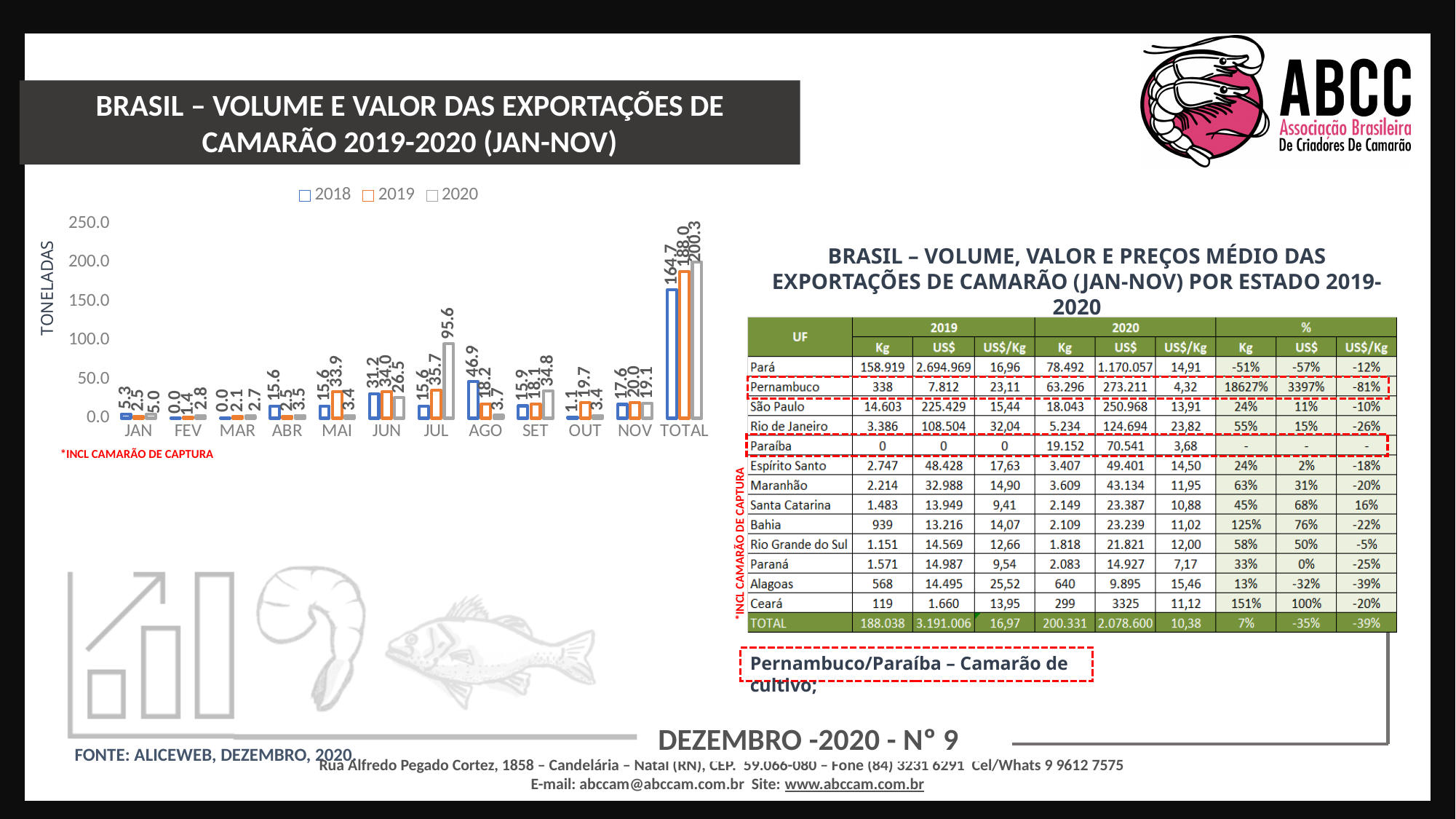
What is the value for 2020 in JUL? 95.6 What is the difference between the TOTAL values for 2020 and 2018? 35.6 Which month has the lowest value for 2018? FEV and MAR (0.0) Which is larger in SET, the value for 2019 or the value for 2020? 2020 Excluding TOTAL, which month has the highest value for 2020? JUL Is the TOTAL value for 2020 greater or less than 150.0? greater How many categories are shown along the x axis of the chart? 12 How many series does the chart legend list? 3 What type of chart is shown on the slide? bar chart What is the value for 2018 in AGO? 46.9 What is the TOTAL value for 2019? 188.0 What is the label on the y axis of the chart? TONELADAS